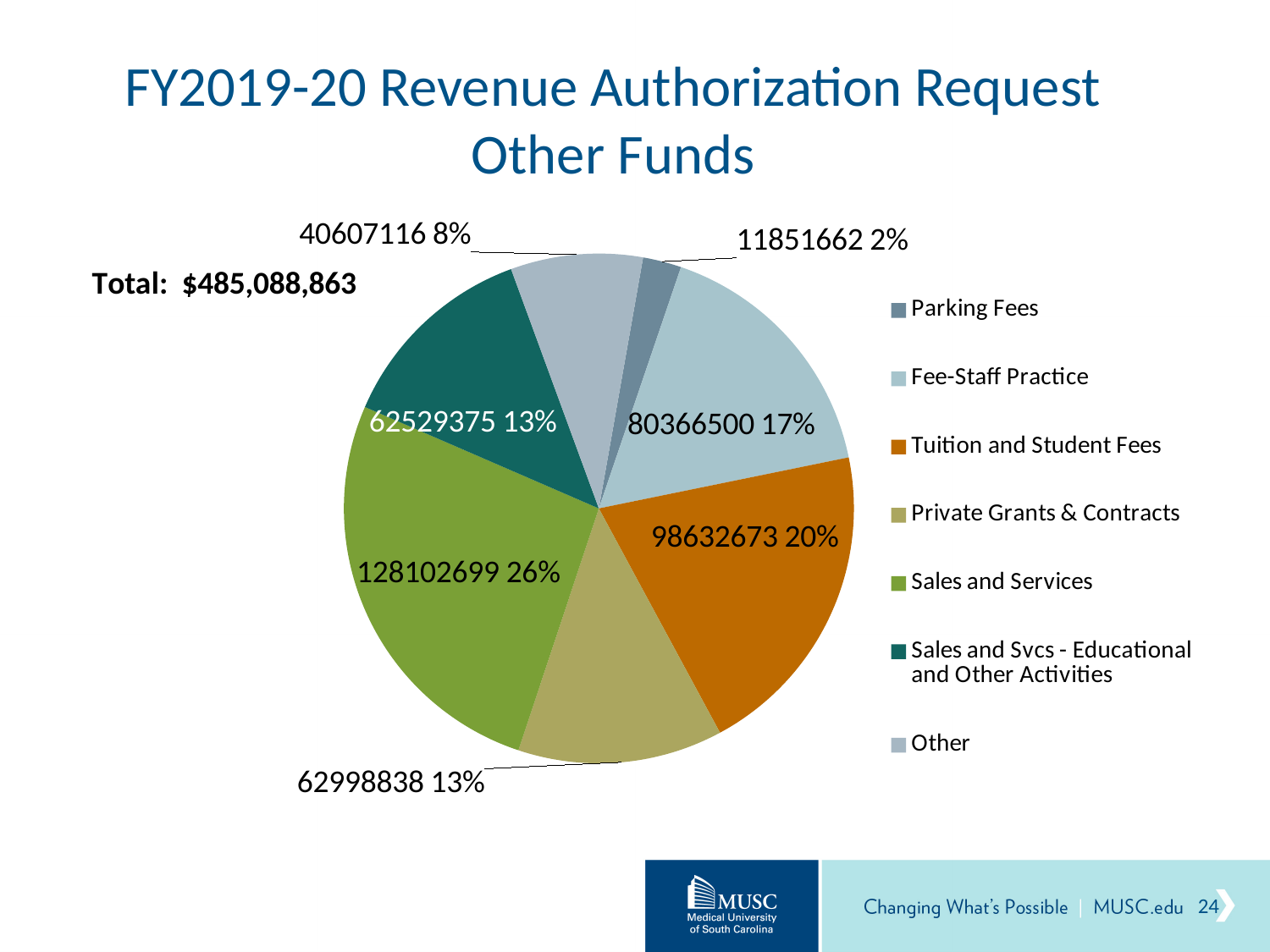
What is the value for Tuition and Student Fees? 98632673 What share of the pie does Other represent? 8% Which category has the largest slice of the pie? Sales and Services What is the difference between the values for Sales and Services and Tuition and Student Fees? 29470026 Which category has the smallest slice of the pie? Parking Fees What share of the pie does Parking Fees represent? 2% How many categories does the legend list? 7 What is the value for Fee-Staff Practice? 80366500 What total is stated on the slide for the chart? $485,088,863 What type of chart is shown on the slide? Pie chart What is the value for Sales and Services? 128102699 Which is larger, the value for Fee-Staff Practice or the value for Private Grants & Contracts? Fee-Staff Practice